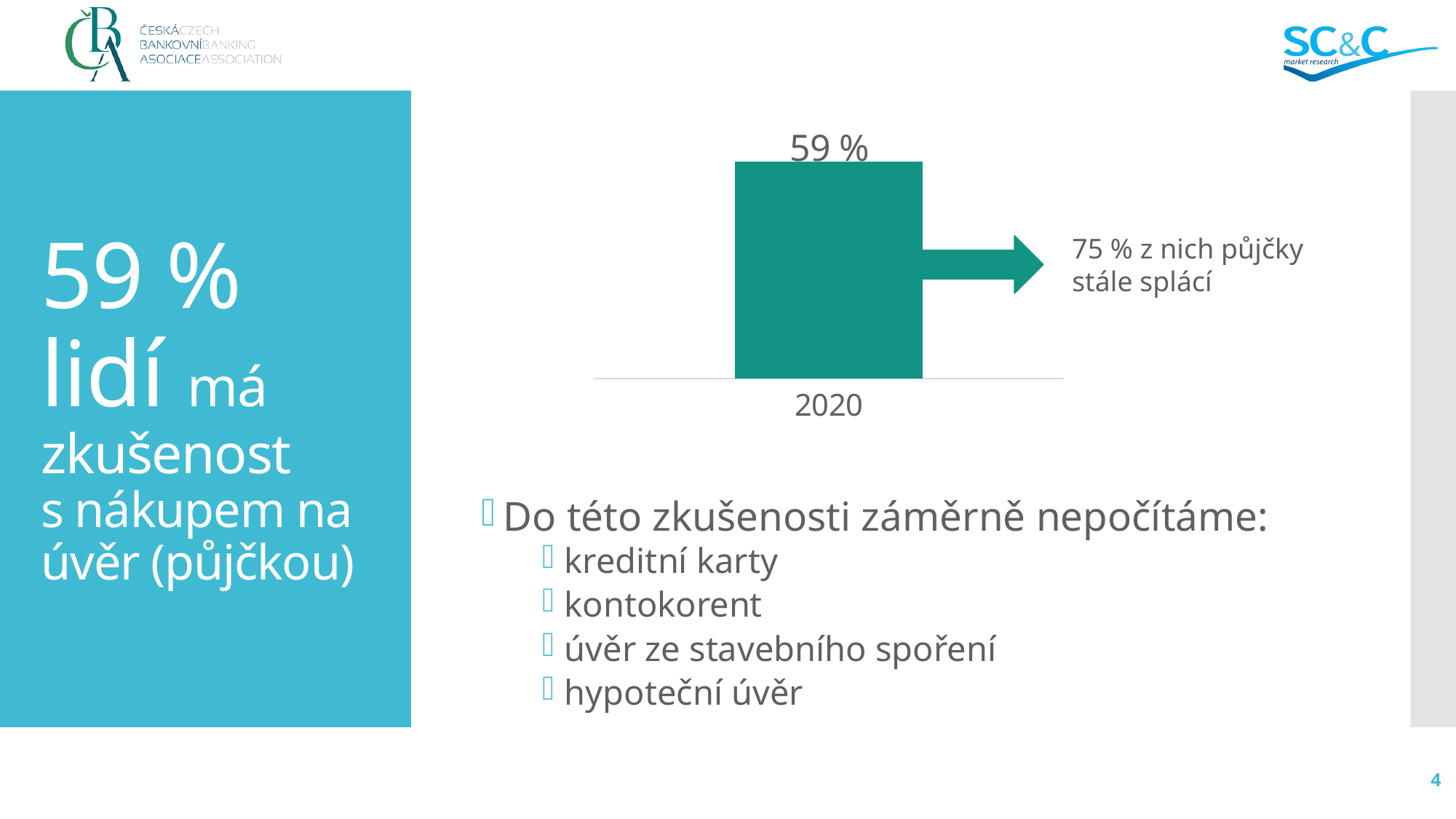
How many bars does the chart contain? 1 What colour is the bar in the chart? teal green What value is shown for 2020 in the bar chart? 59 % What kind of chart is shown on the slide? bar chart What category label appears under the bar on the x axis? 2020